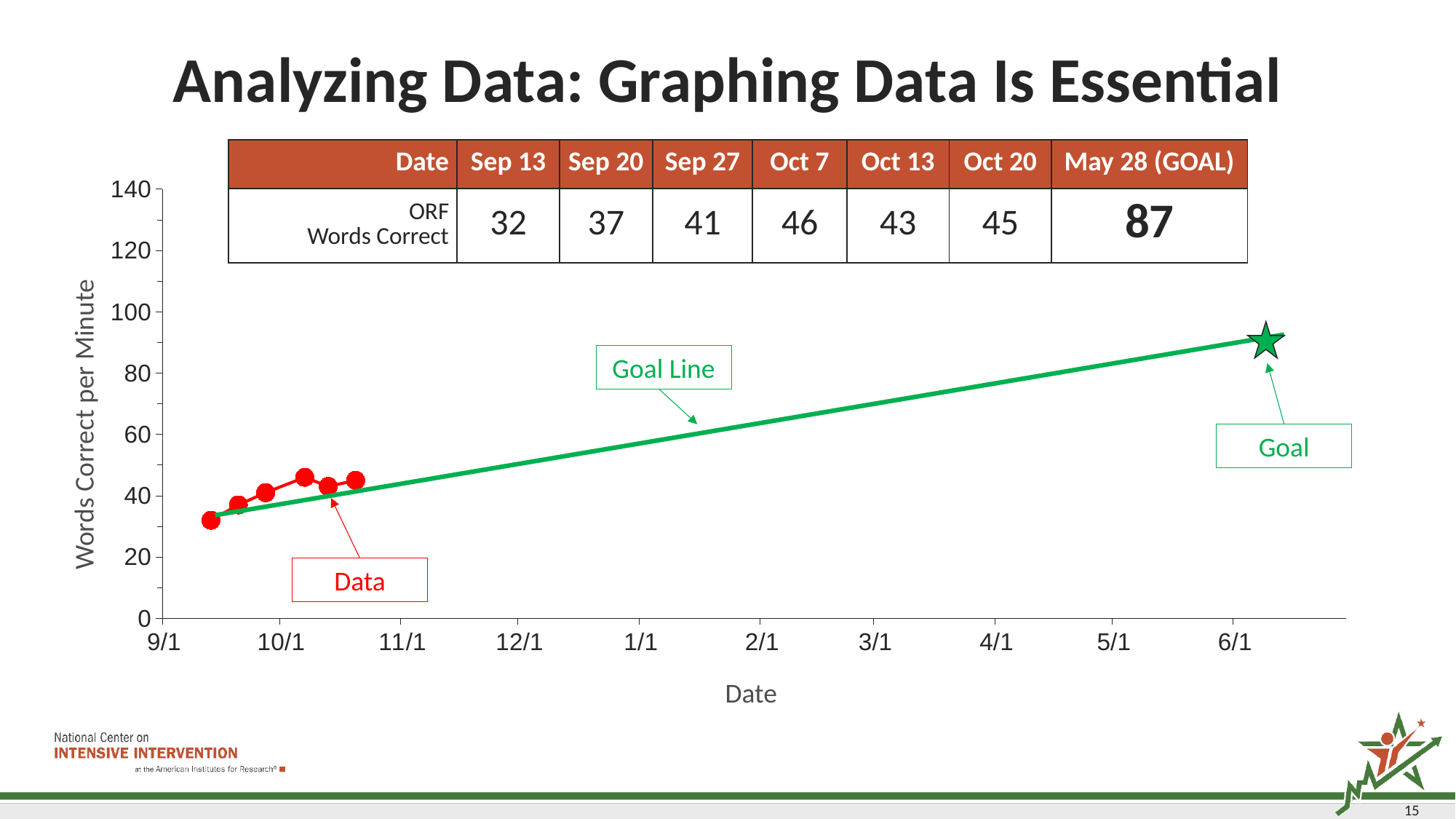
Which date has the lowest ORF Words Correct value? Sep 13 What is the goal value for May 28? 87 What is the ORF Words Correct value for Sep 13? 32 Which is larger, the ORF Words Correct value for Oct 13 or for Oct 20? Oct 20 What is the ORF Words Correct value for Oct 7? 46 What type of chart is shown on the slide? line chart What is the label on the y axis of the chart? Words Correct per Minute What is the difference between the ORF Words Correct values for Oct 20 and Sep 13? 13 Is the goal value marked by the star greater or less than 80? greater What colour is the goal line on the chart? green Which date has the highest ORF Words Correct value among the plotted data points (excluding the goal)? Oct 7 How many red data points are plotted on the chart? 6